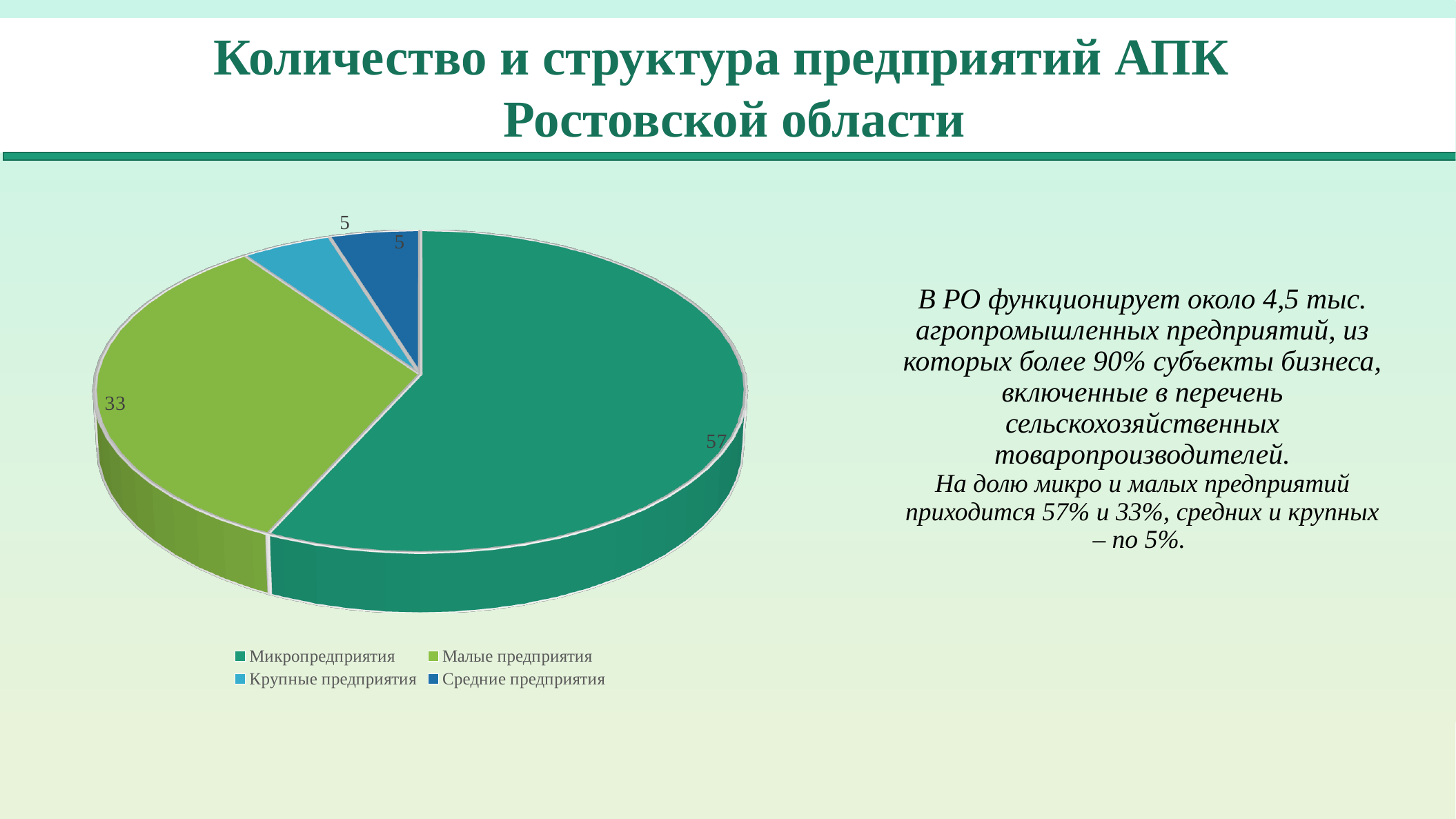
What is the value shown for Микропредприятия in the pie chart? 57 What is the difference between the values for Микропредприятия and Малые предприятия? 24 What is the difference between the values for Малые предприятия and Крупные предприятия? 28 How many categories does the pie chart have? 4 What is the value shown for Малые предприятия in the pie chart? 33 How many entries does the legend of the pie chart list? 4 What is the value shown for Крупные предприятия in the pie chart? 5 Which category has the largest slice in the pie chart? Микропредприятия What is the value shown for Средние предприятия in the pie chart? 5 What kind of chart is shown on the slide? Pie chart Which legend entry is shown in light green in the pie chart? Малые предприятия Which is larger, the slice for Малые предприятия or the slice for Средние предприятия? Малые предприятия